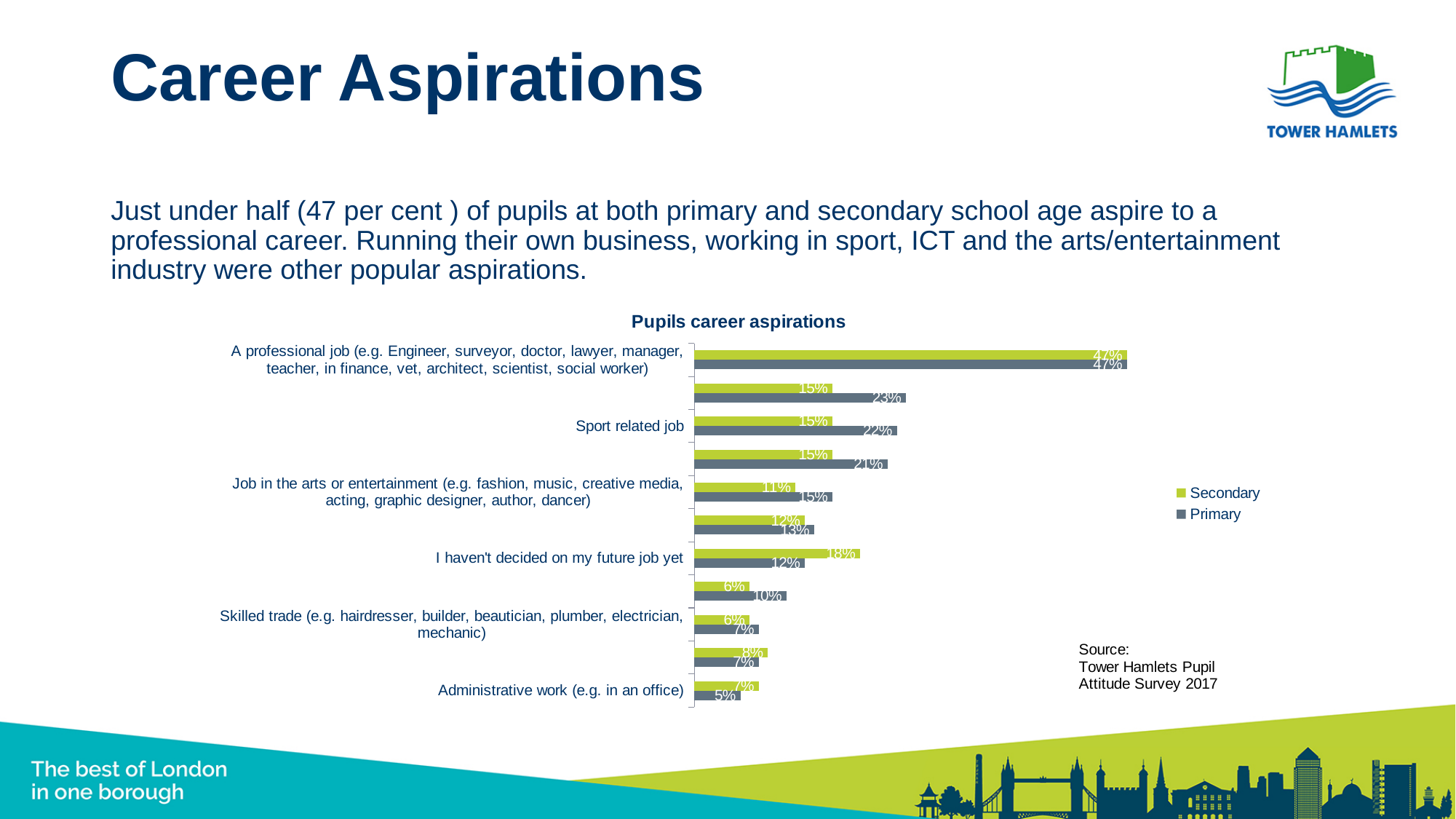
Which category has the highest Primary value? A professional job What is the title of the chart? Pupils career aspirations How many series does the legend of the chart list? 2 What is the Primary value for 'Administrative work (e.g. in an office)'? 5% How many categories are plotted in the chart? 11 What is the Primary value for 'Sport related job'? 22% What is the Secondary value for 'A professional job'? 47% What is the Secondary value for 'I haven't decided on my future job yet'? 18% What is the difference between the Primary and Secondary values for 'Sport related job'? 7 percentage points What kind of chart is shown on the slide? Bar chart Which category has the lowest Primary value? Administrative work (e.g. in an office) For 'Job in the arts or entertainment', which is larger: the Primary value or the Secondary value? Primary